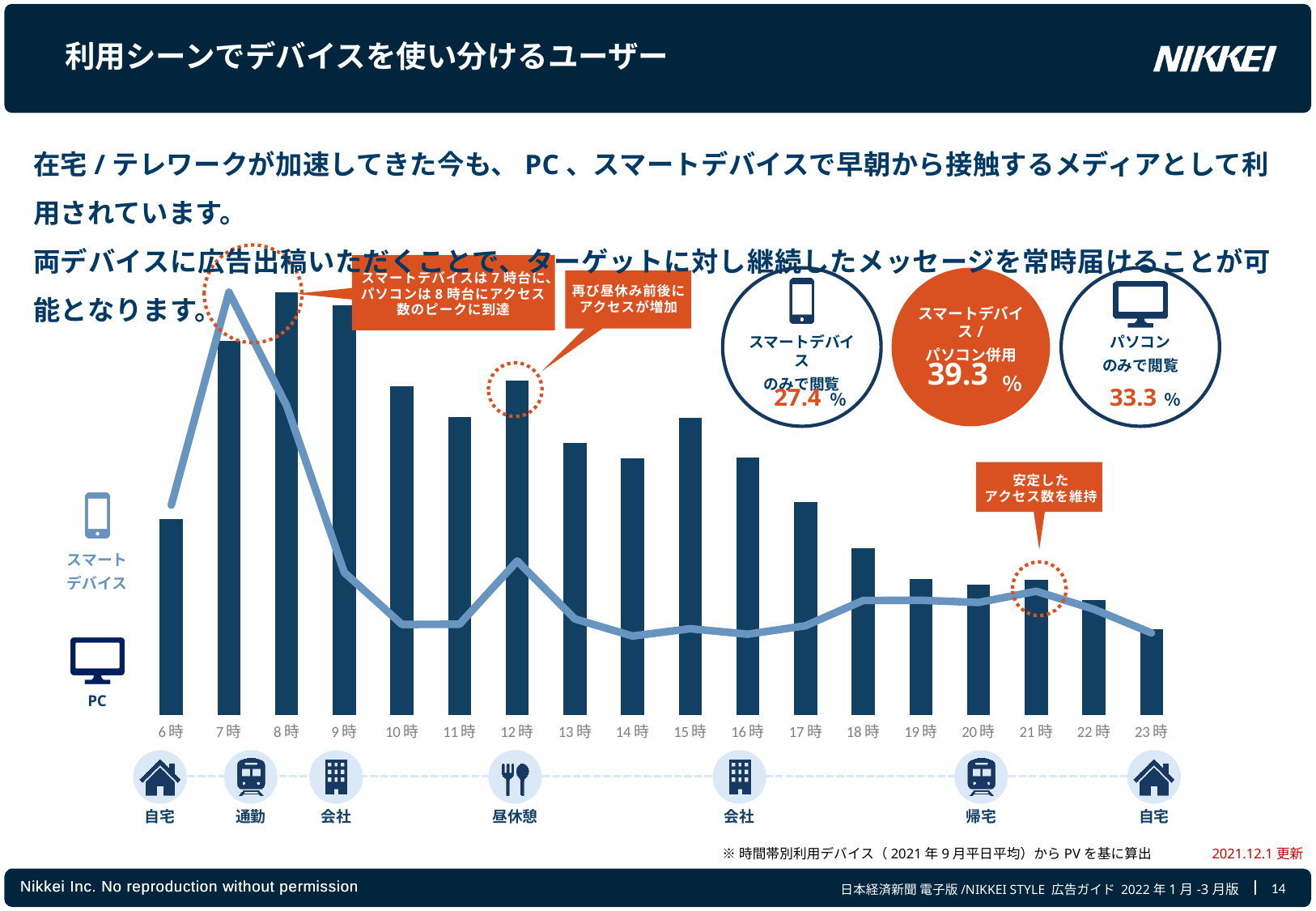
What percentage of users view only on a smart device (スマートデバイスのみで閲覧)? 27.4% How many hourly categories are shown along the x axis of the chart? 18 Which hour has the tallest PC bar in the chart? 8時 What percentage of users use both a smart device and a PC (スマートデバイス/パソコン併用)? 39.3% Which hour has the shortest PC bar in the chart? 23時 Do the PC bars rise or fall from 16時 to 19時? Fall At which hour does the smart device line reach its peak? 7時 What kind of chart is used to show the hourly access data on the slide? A bar chart combined with a line How many series does the chart's legend list? 2 Which is taller, the PC bar at 8時 or the PC bar at 12時? 8時 Which is taller, the PC bar at 7時 or the PC bar at 9時? 9時 What percentage of users view only on a PC (パソコンのみで閲覧)? 33.3%